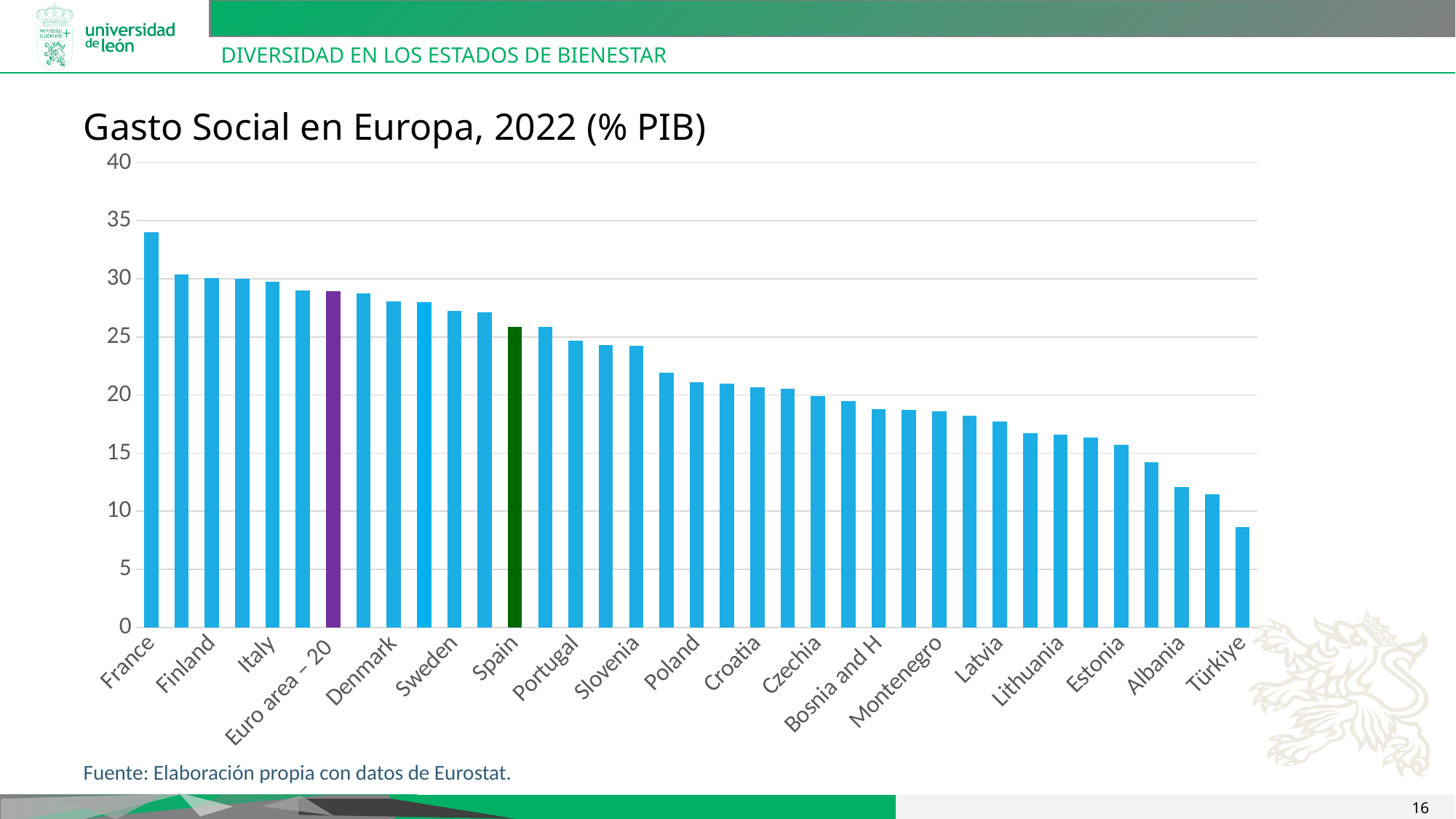
Is the value for Poland greater or less than 20? greater Which country has the highest social spending as a share of GDP in the chart? France What kind of chart is shown on the slide? Bar chart Is the value for Latvia greater or less than 20? less Which has a higher value, Spain or Euro area – 20? Euro area – 20 Which has a higher value, Albania or Denmark? Denmark Do the bar values rise or fall from left to right across the chart? Fall Is the value for Euro area – 20 greater or less than 30? less What colour is the bar for Spain? Dark green Which country has the lowest social spending as a share of GDP in the chart? Türkiye